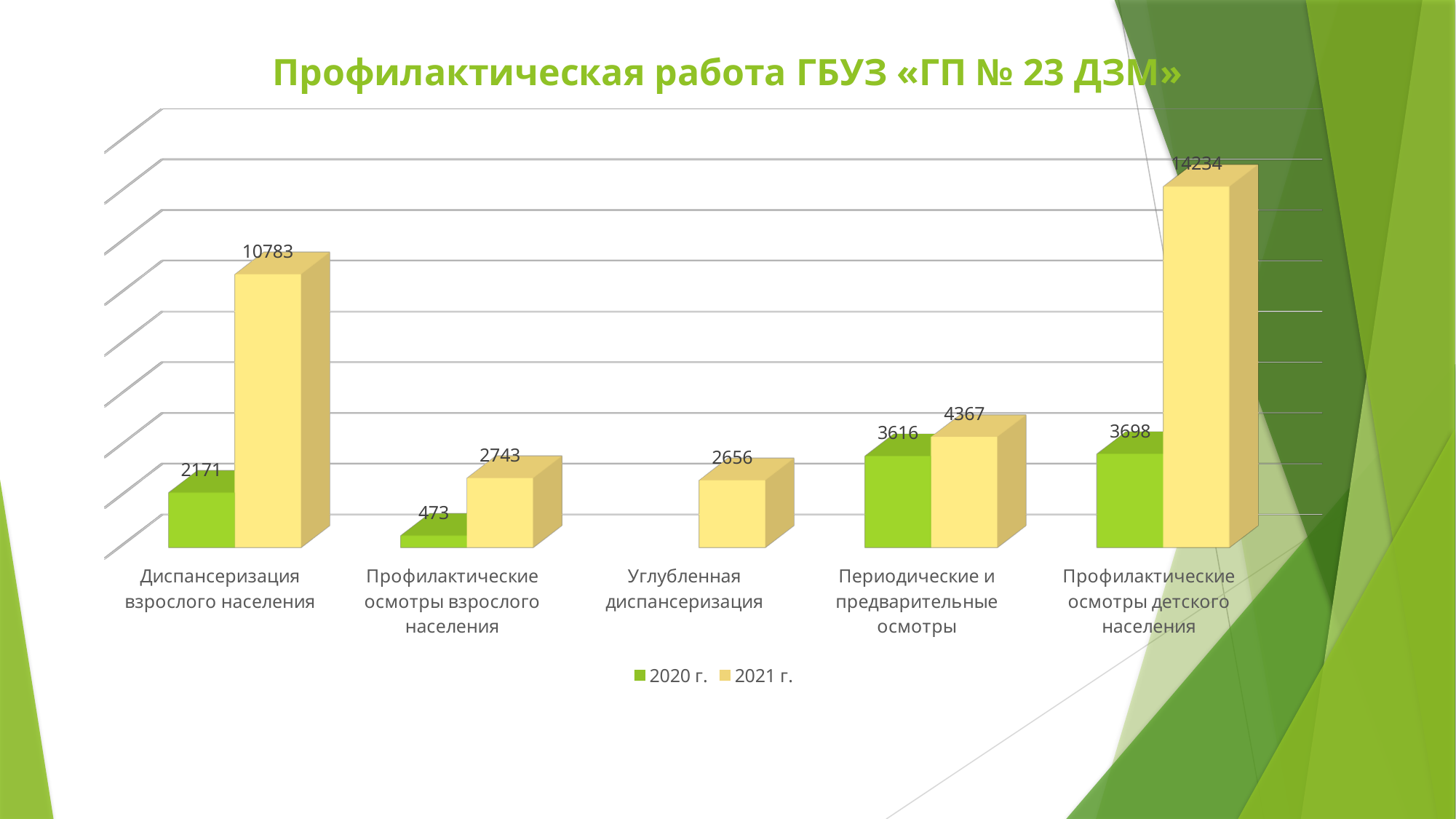
What is the value for 2021 г. for Диспансеризация взрослого населения? 10783 What is the difference between the 2021 г. and 2020 г. values for Профилактические осмотры детского населения? 10536 What is the value for 2020 г. for Профилактические осмотры взрослого населения? 473 How many categories are shown on the x axis? 5 Which category has the highest value for 2021 г.? Профилактические осмотры детского населения What kind of chart is shown on the slide? Bar chart What is the value for 2020 г. for Периодические и предварительные осмотры? 3616 Which is larger for Периодические и предварительные осмотры: the 2020 г. value or the 2021 г. value? 2021 г. What is the title of the chart? Профилактическая работа ГБУЗ «ГП № 23 ДЗМ» What is the value for 2021 г. for Углубленная диспансеризация? 2656 Which category has the lowest value for 2020 г.? Профилактические осмотры взрослого населения How many series does the legend list? 2